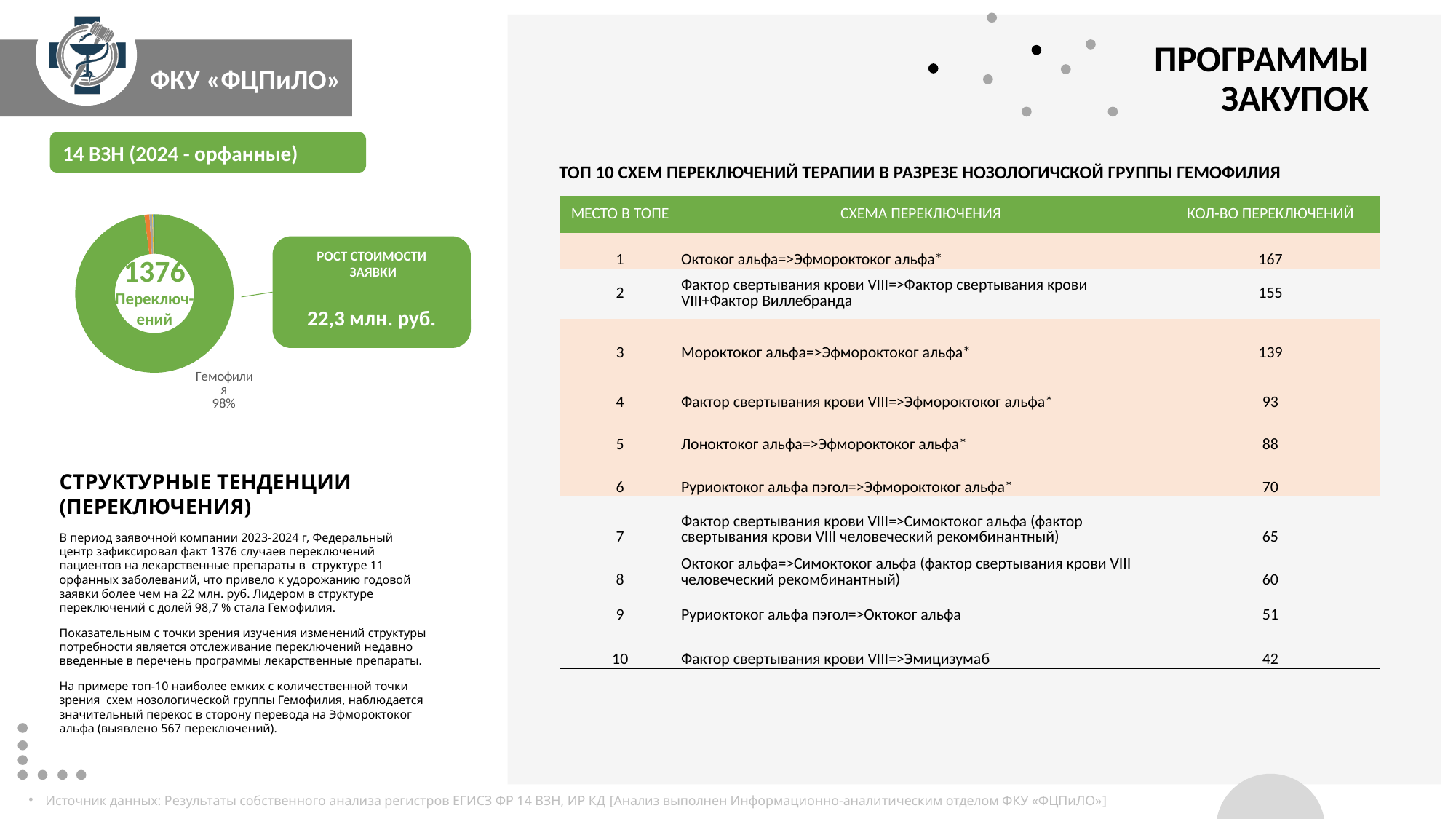
What is the only category label printed next to the doughnut chart? Гемофилия What kind of chart is shown on the left of the slide under the heading "14 ВЗН (2024 - орфанные)"? pie (doughnut) chart In the doughnut chart, what share is shown for Гемофилия? 98% Is the share for Гемофилия in the doughnut chart greater or less than 50%? greater What word is printed under the number 1376 in the centre of the doughnut chart? Переключений Which category has the largest slice in the doughnut chart? Гемофилия What number is printed in the centre of the doughnut chart? 1376